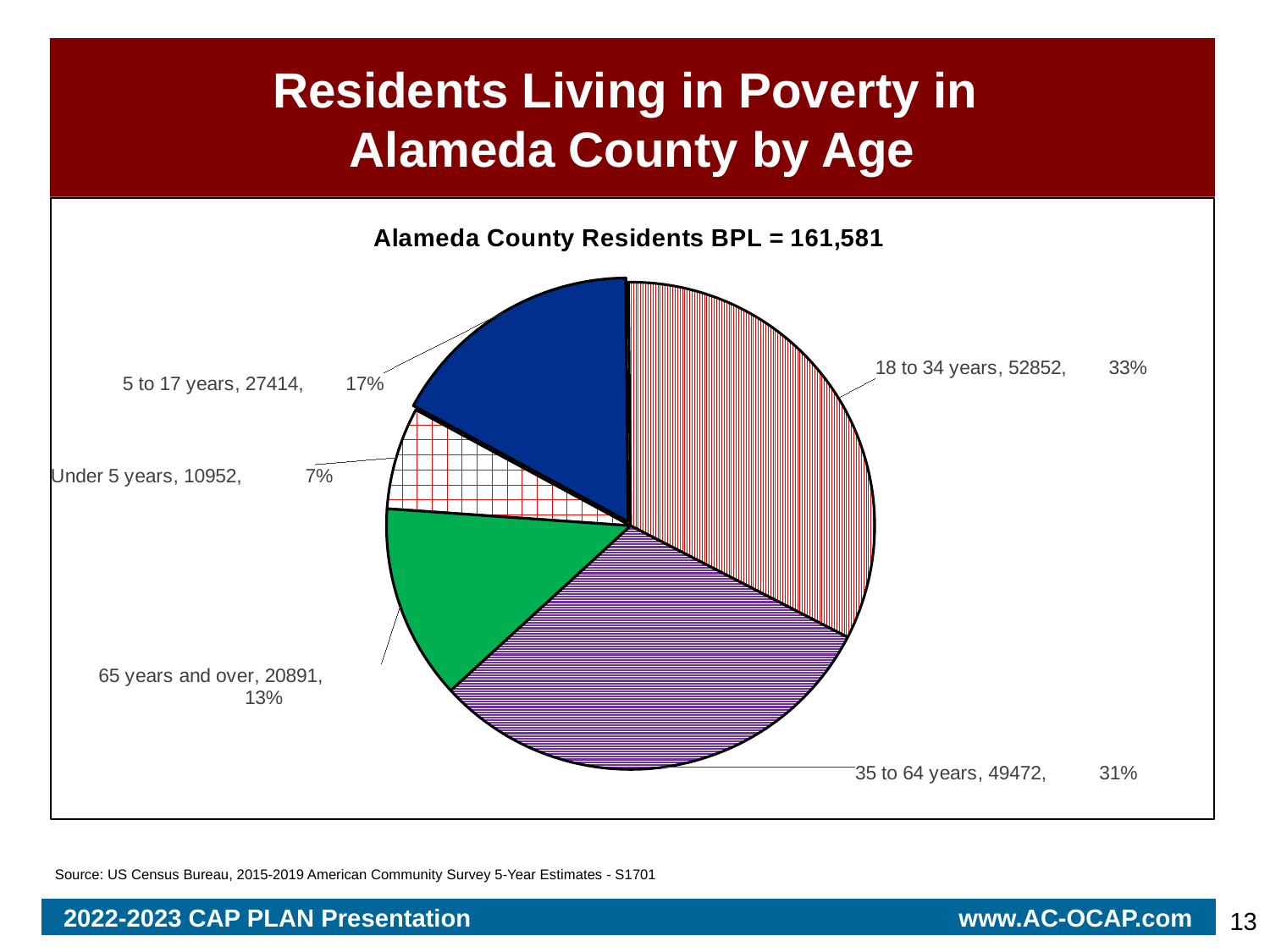
What percentage share of the pie is 5 to 17 years? 17% Which age group has the smallest slice of the pie? Under 5 years Which age group has the largest slice of the pie? 18 to 34 years What kind of chart is shown on the slide? pie chart Which is larger, the value for 5 to 17 years or the value for 65 years and over? 5 to 17 years What percentage share of the pie is 65 years and over? 13% What is the value shown for Under 5 years? 10952 What is the value shown for 35 to 64 years? 49472 How many age categories are shown in the pie chart? 5 How many residents aged 18 to 34 years are living in poverty according to the chart? 52852 What is the difference between the values for 18 to 34 years and 35 to 64 years? 3380 What is the chart's title? Alameda County Residents BPL = 161,581